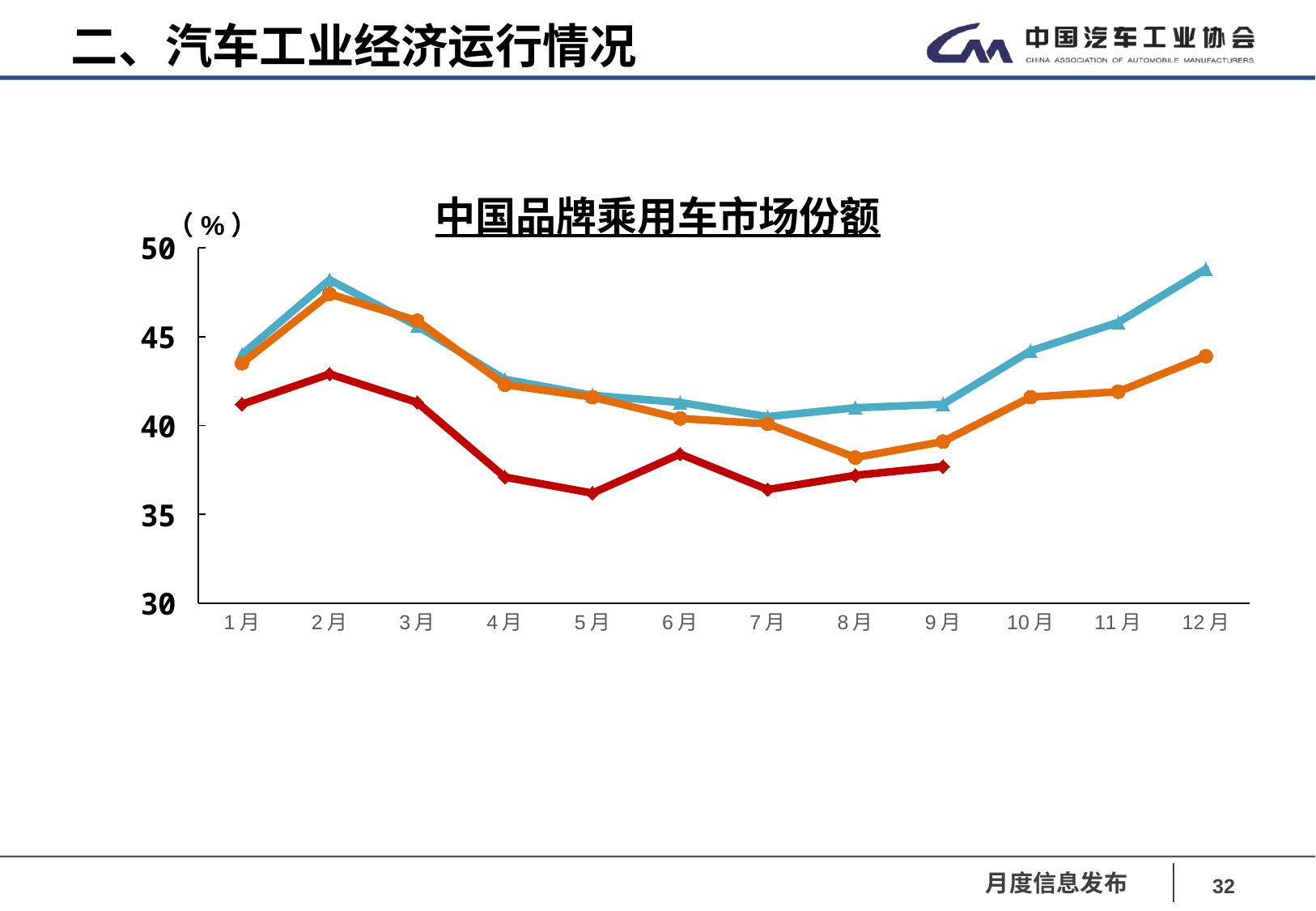
What is the title of the chart? 中国品牌乘用车市场份额 In which month does the orange line reach its highest value? 2月 What unit is shown on the y axis of the chart? % In which month does the orange line reach its lowest value? 8月 Is the value of the orange line at 8月 greater or less than 40? less At 12月, which line has the higher value, the blue line or the orange line? the blue line Is the value of the blue line at 12月 greater or less than 45? greater Is the value of the red line at 5月 greater or less than 40? less How many data points does the red line have? 9 How many months are shown on the x axis of the chart? 12 What kind of chart is shown on the slide? line chart Does the blue line rise or fall from 9月 to 12月? rise